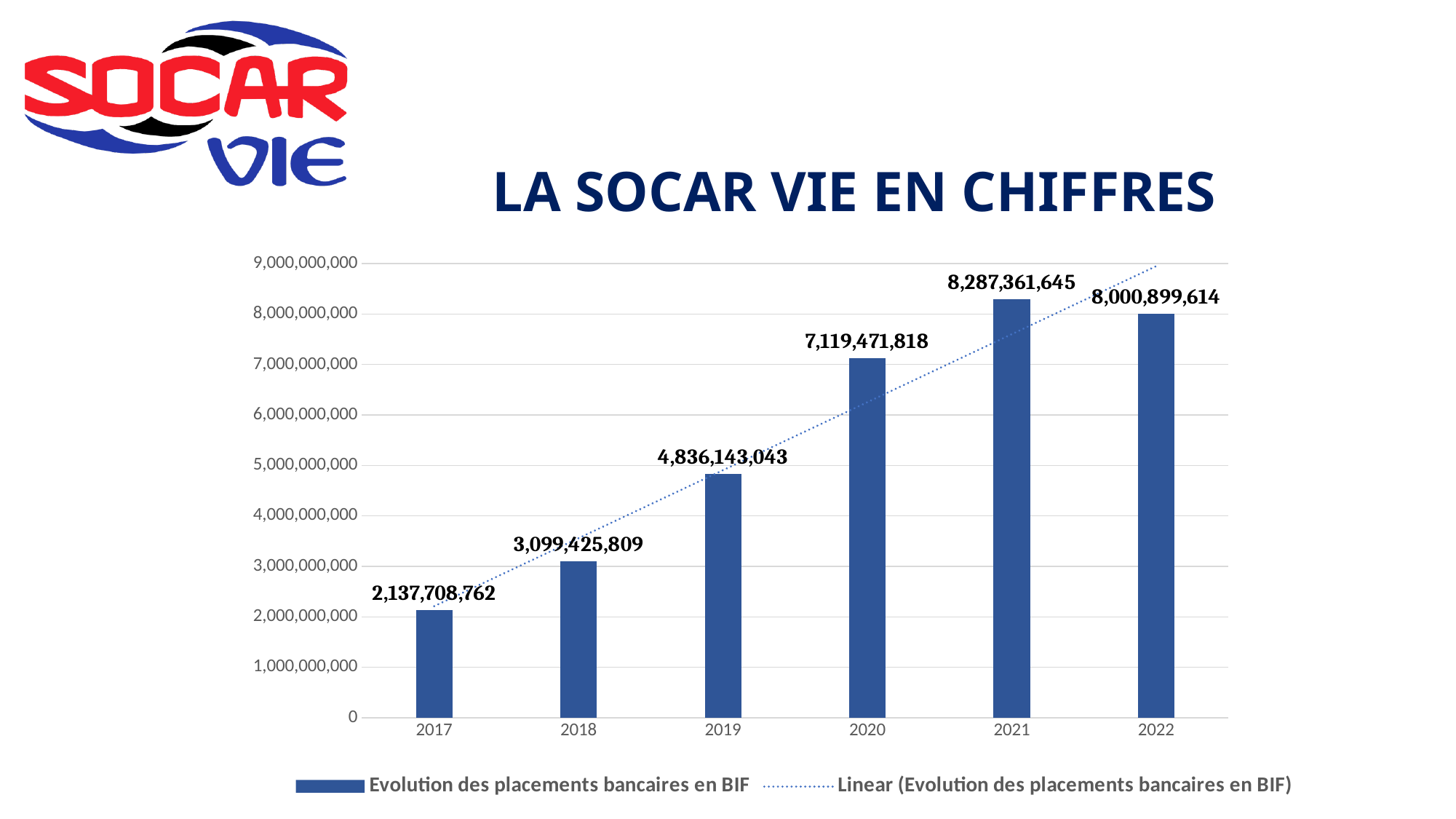
Which year has the lowest value? 2017 How many years are shown on the x axis? 6 What is the difference between the values for 2021 and 2022? 286,462,031 How many entries does the legend list? 2 What kind of chart is shown on the slide? Bar chart What is the value for 2020? 7,119,471,818 Which is larger, the value for 2019 or the value for 2020? 2020 What is the value for 2022? 8,000,899,614 Which year has the highest value? 2021 What is the difference between the values for 2018 and 2017? 961,717,047 Is the value for 2019 greater or less than 5,000,000,000? less What is the value for 2017? 2,137,708,762